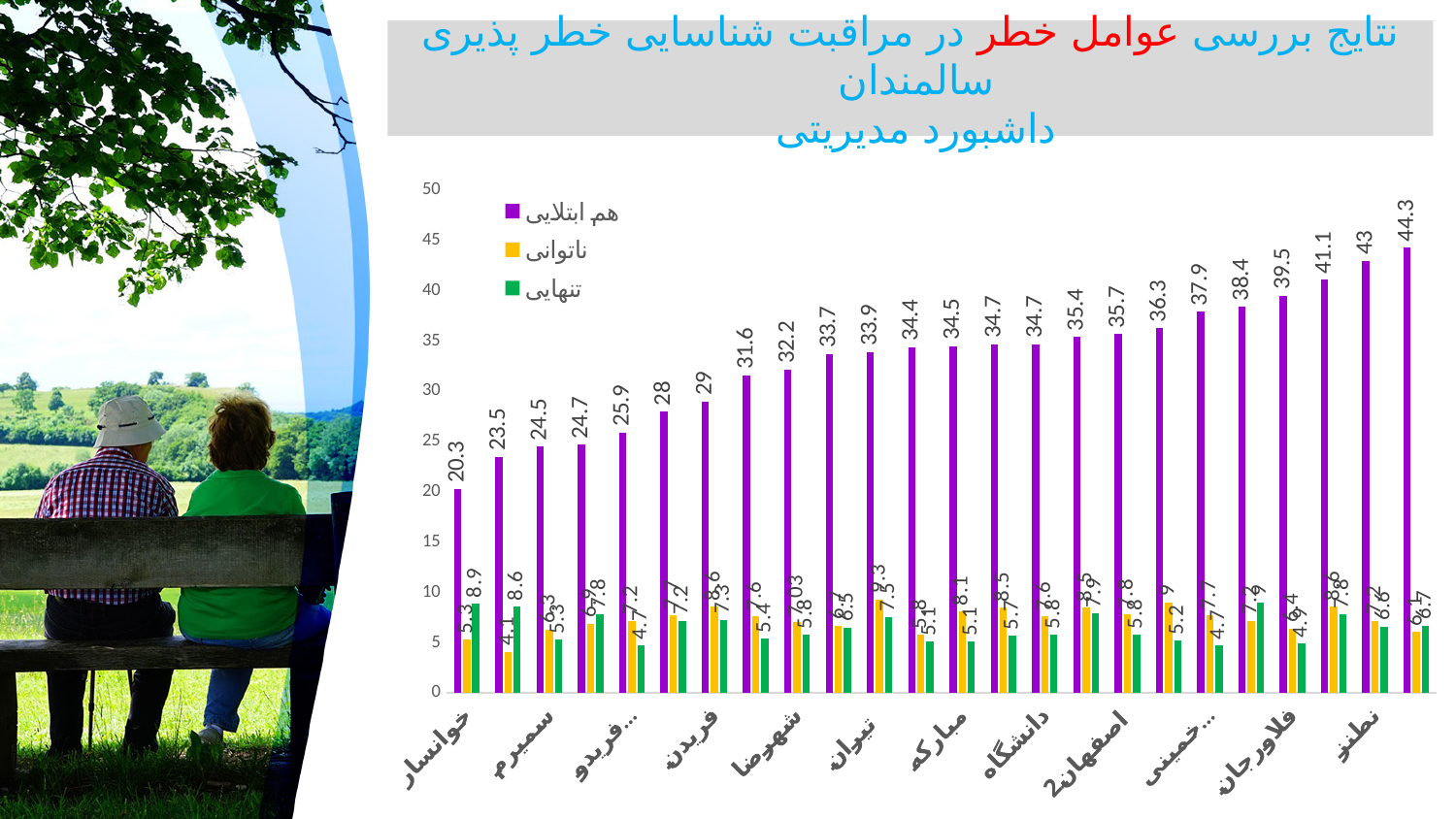
Is the tallest purple (هم ابتلایی) bar greater or less than 40? greater What kind of chart is shown on the slide? bar chart Which series is shown in purple according to the legend? هم ابتلایی Which series is shown in green according to the legend? تنهایی What is the lowest value among the purple (هم ابتلایی) bars? 20.3 Is the shortest purple (هم ابتلایی) bar greater or less than 25? less What is the highest value among the purple (هم ابتلایی) bars? 44.3 Which is larger, the leftmost purple bar or the rightmost purple bar? the rightmost purple bar How many purple (هم ابتلایی) bars are plotted in the chart? 24 Do the purple (هم ابتلایی) bars rise or fall from left to right along the x axis? rise How many series does the legend list? 3 What is the difference between the highest and lowest purple (هم ابتلایی) bar values? 24